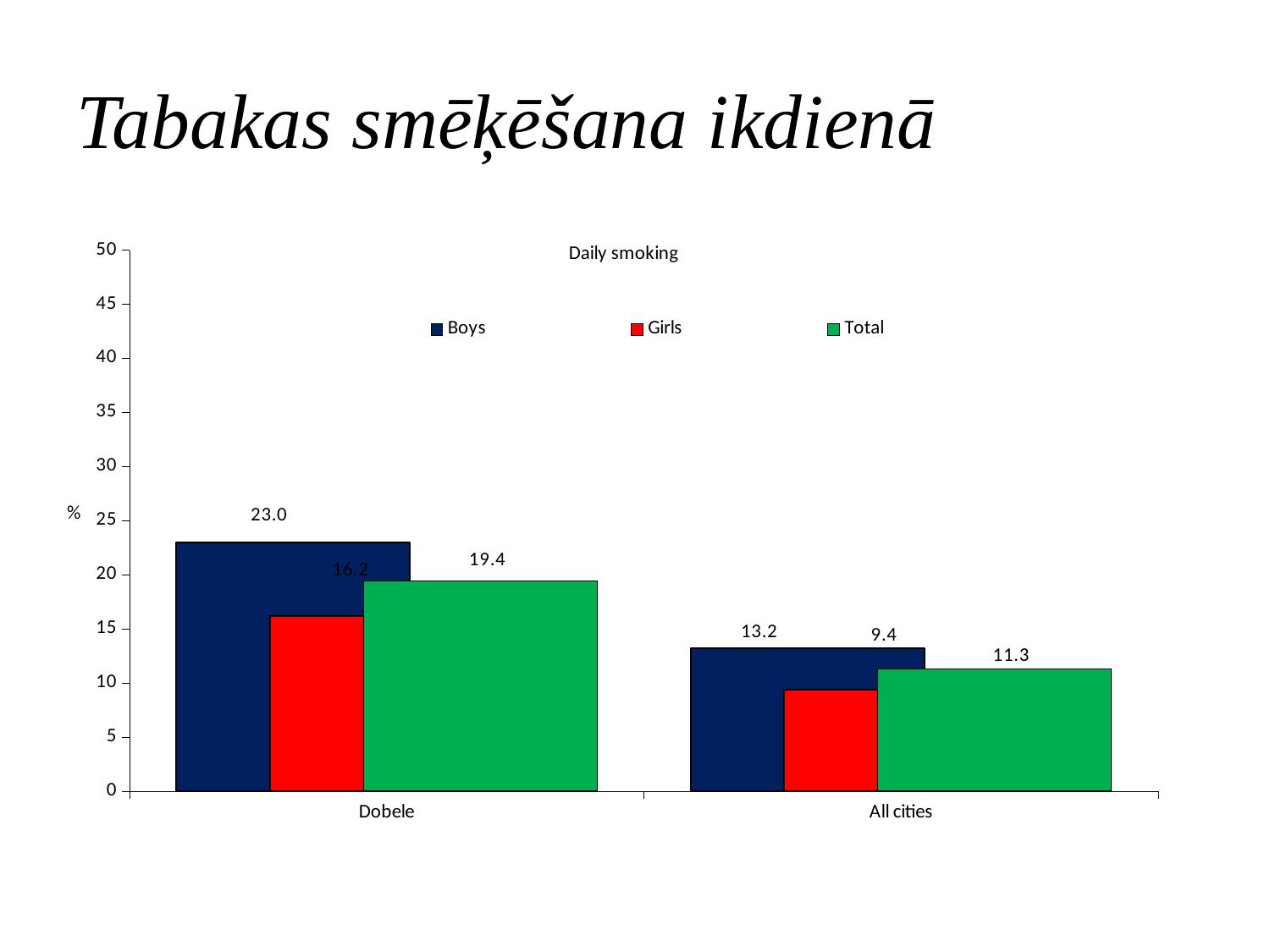
Which series has the lowest value in All cities? Girls What is the value for Total in All cities? 11.3 What is the difference between the Boys values for Dobele and All cities? 9.8 How many series does the legend list? 3 What is the value for Total in Dobele? 19.4 Which is larger: the Girls value in Dobele or the Total value in All cities? Girls in Dobele Which series has the highest value in Dobele? Boys How many categories are shown on the x axis? 2 What kind of chart is shown? Bar chart What is the value for Girls in All cities? 9.4 What is the title of the chart? Daily smoking What is the value for Boys in Dobele? 23.0